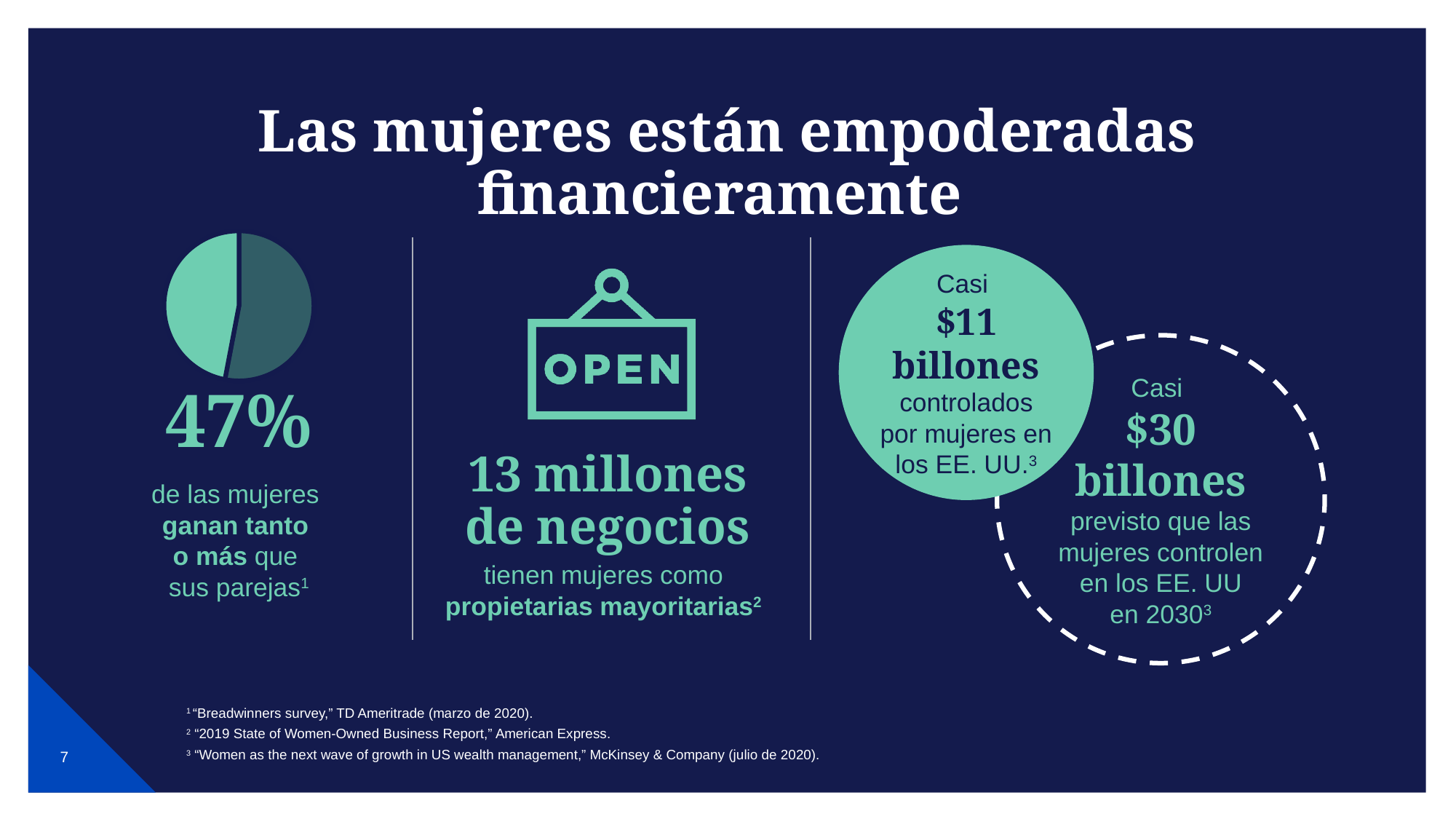
What two colours are used for the slices of the pie chart on the left of the slide? light teal and dark teal According to the pie chart on the left of the slide, what percentage of women earn as much as or more than their partners? 47% How many slices does the pie chart on the left of the slide have? 2 What is the title of the slide containing the pie chart? Las mujeres están empoderadas financieramente Is the share shown by the light teal slice of the pie chart on the left of the slide greater or less than 50%? less What kind of chart is shown on the left of the slide, above the 47% figure? pie chart What share of the pie chart on the left of the slide does the light teal slice represent, according to the figure printed below it? 47%